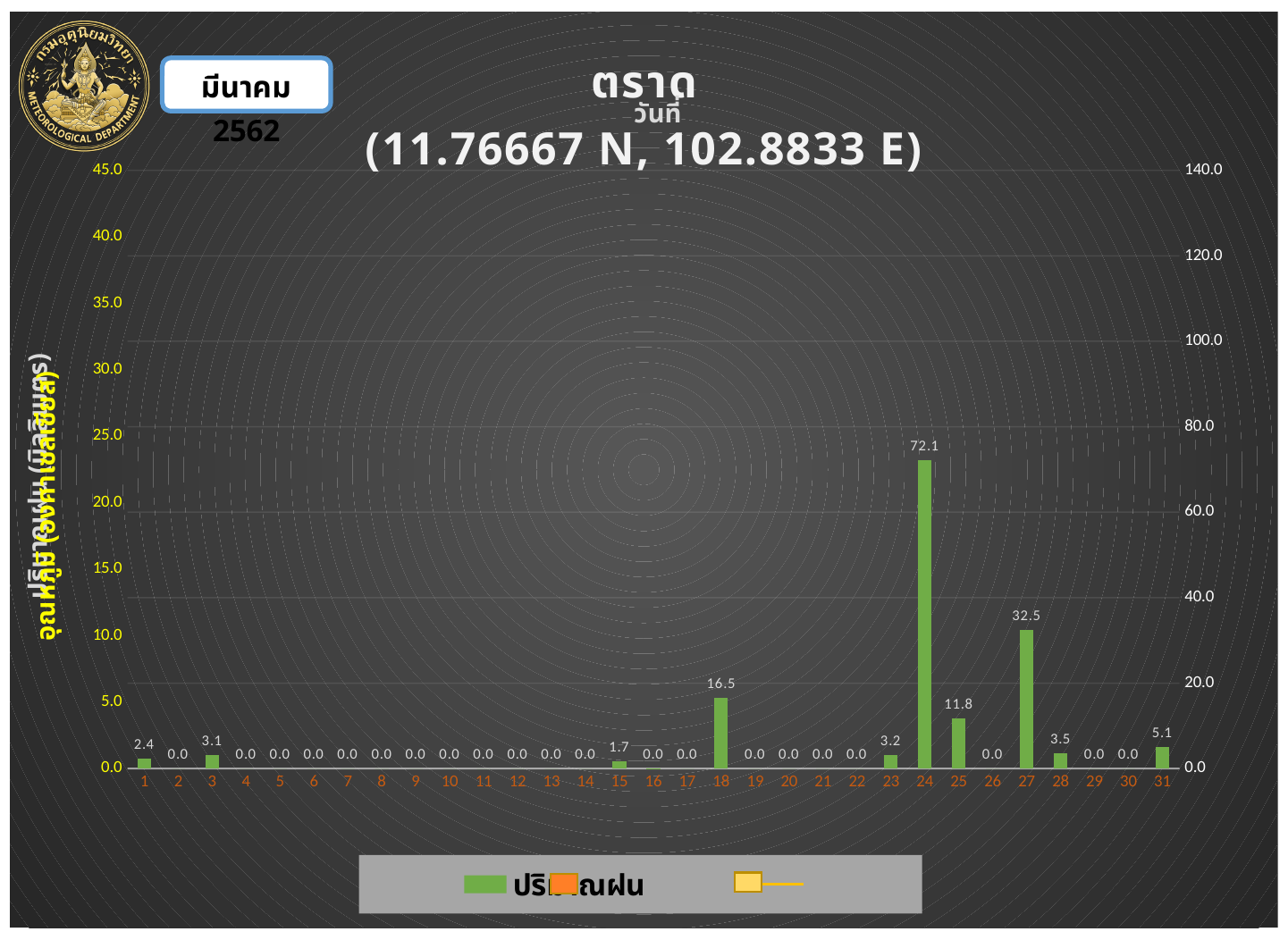
What is the value for day 24? 72.1 What is the value for day 31? 5.1 What is the value for day 27? 32.5 What kind of chart is shown on the slide? bar chart Which is larger, the value for day 18 or the value for day 25? day 18 What is the value for day 18? 16.5 Is the value for day 24 greater or less than 60.0 on the right axis? greater What is the title of the chart? ตราด (11.76667 N, 102.8833 E) What is the difference between the values for day 25 and day 23? 8.6 Which day has the highest value? 24 How many days are shown on the x axis? 31 What is the difference between the values for day 24 and day 27? 39.6